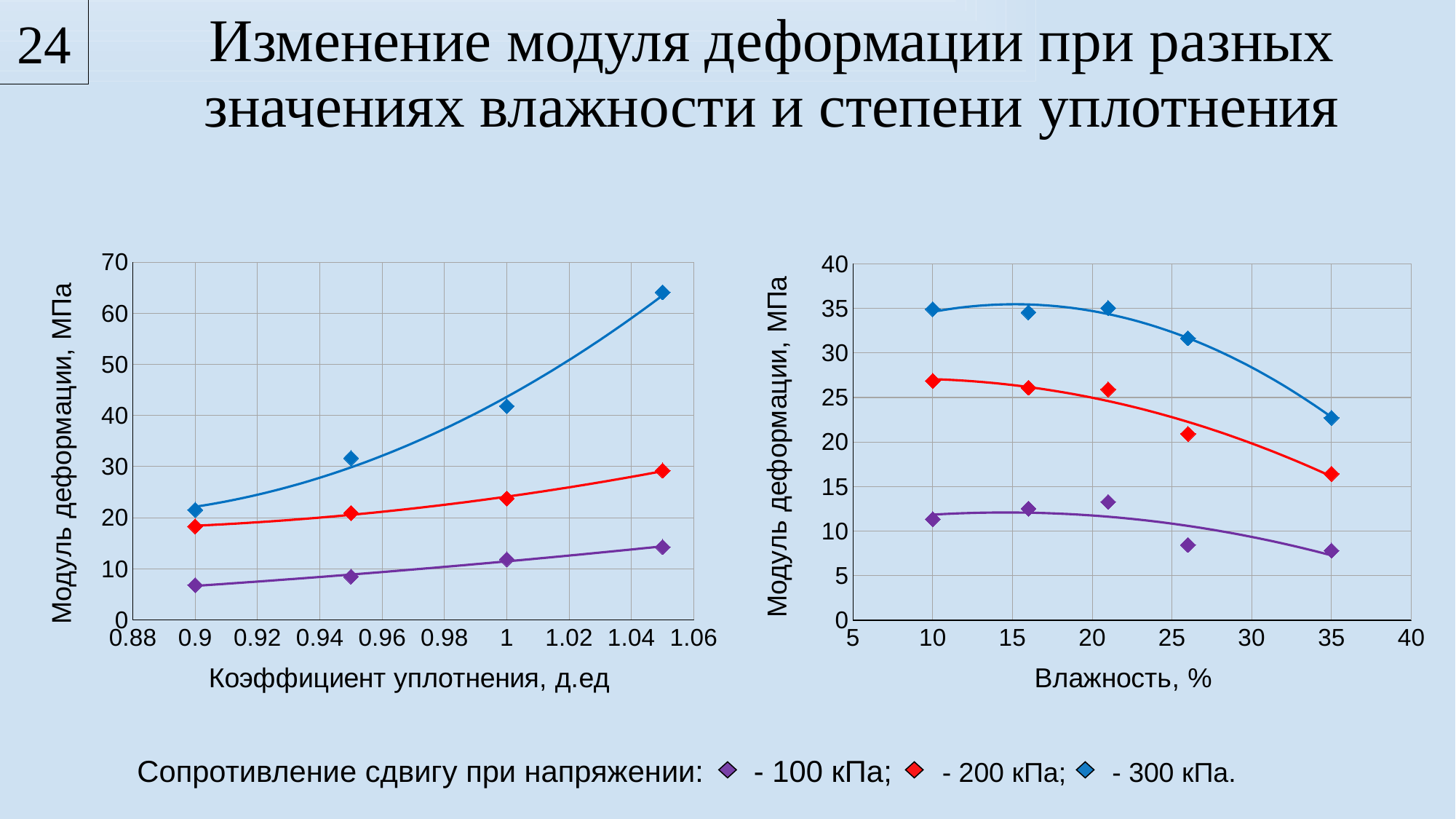
What kind of chart is the left chart on the slide? scatter chart In the right chart (Влажность, %), how many data points does the 200 кПа series have? 5 In the left chart, at a compaction coefficient of 1.05, which series has the larger value: 300 кПа or 200 кПа? 300 кПа In the left chart (Коэффициент уплотнения), how many data points does the 300 кПа series have? 4 What is the x-axis label of the right chart? Влажность, % In the left chart, do the values of the 300 кПа series rise or fall as the compaction coefficient increases? rise In the left chart, is the value of the 100 кПа series at a compaction coefficient of 0.9 greater or less than 10? less In the right chart, is the value of the 200 кПа series at 35% humidity greater or less than 20? less In the right chart, do the values of the 200 кПа series rise or fall as humidity increases from 10% to 35%? fall In the left chart, is the value of the 300 кПа series at a compaction coefficient of 1.05 greater or less than 60? greater How many series does the legend at the bottom of the slide list? 3